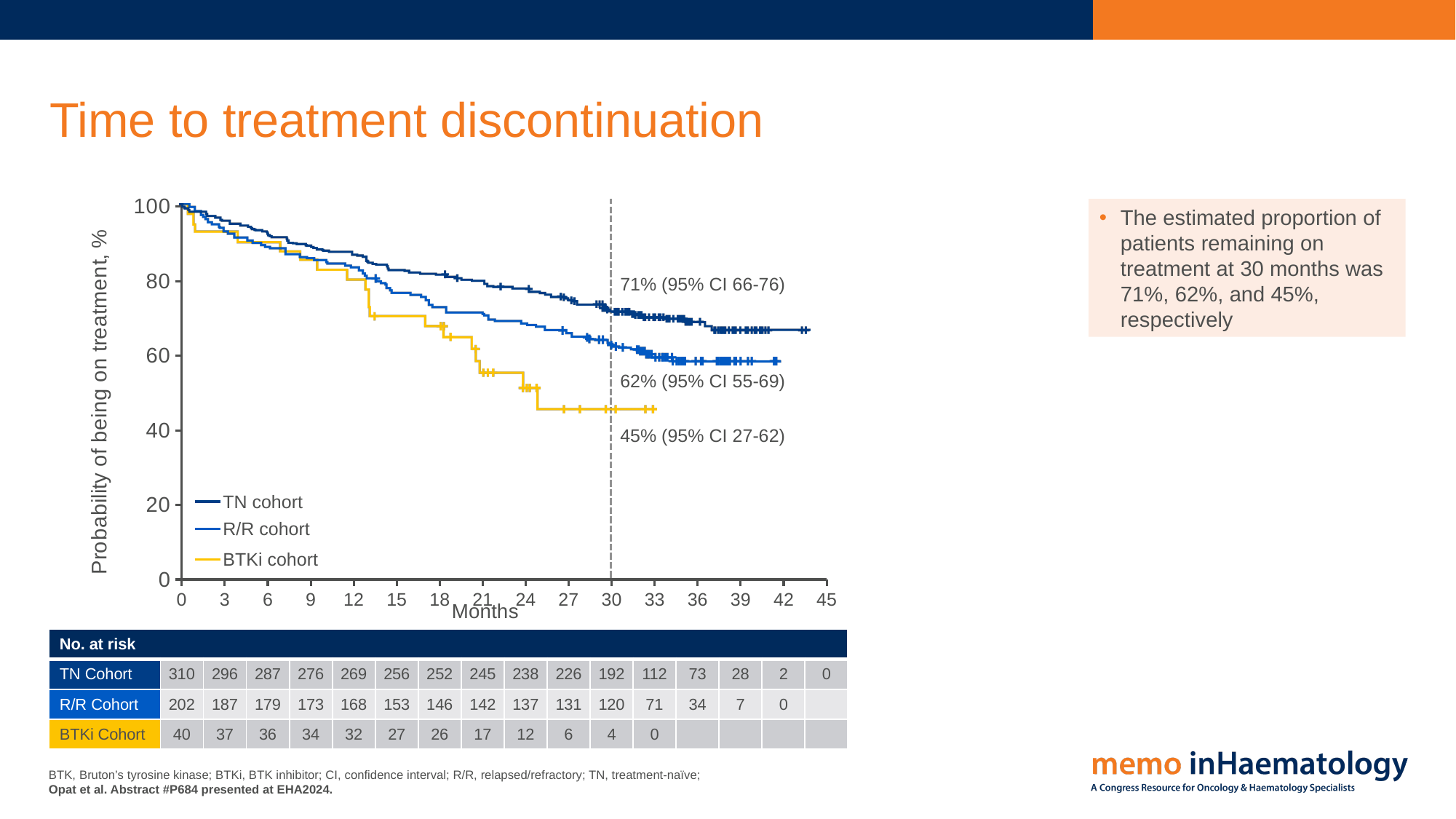
Is the probability of being on treatment for the BTKi cohort at 24 months greater or less than 60%? less What is the estimated probability of being on treatment at 30 months for the BTKi cohort? 45% (95% CI 27-62) What is the difference in percentage points between the TN cohort and the BTKi cohort at 30 months? 26 percentage points Which cohort has the highest probability of being on treatment at 30 months? TN cohort According to the number-at-risk table, how many patients were at risk in the BTKi cohort at month 0? 40 Do the curves rise or fall as months increase? Fall At 30 months, which cohort has the larger probability of being on treatment, the TN cohort or the R/R cohort? TN cohort What kind of chart is shown on the slide? Line chart (Kaplan-Meier curve) What is the estimated probability of being on treatment at 30 months for the R/R cohort? 62% (95% CI 55-69) How many cohorts does the legend list? 3 What is the estimated probability of being on treatment at 30 months for the TN cohort? 71% (95% CI 66-76) Which cohort has the lowest probability of being on treatment at 30 months? BTKi cohort